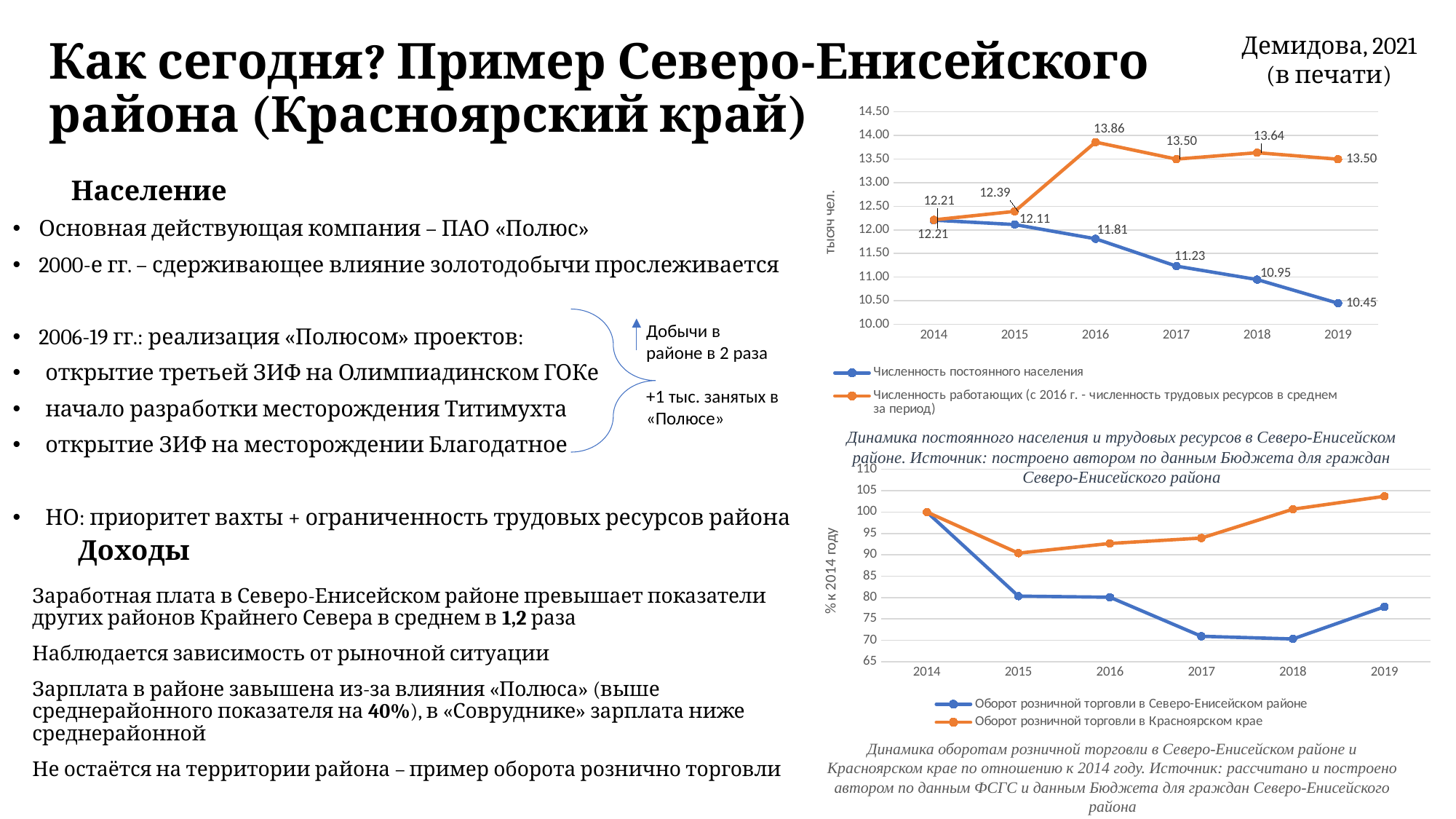
In the bottom chart, is the value for Оборот розничной торговли в Северо-Енисейском районе in 2018 greater or less than 75? less In the top chart, what is the difference between Численность работающих and Численность постоянного населения in 2019? 3.05 In the top chart, in which year was the permanent population (blue series) highest? 2014 How many years are plotted on the x axis of the top chart? 6 In the top chart, which series has the larger value in 2017: Численность постоянного населения or Численность работающих? Численность работающих In the top chart, does the permanent population rise or fall from 2014 to 2019? fall In the top chart, in which year was the Численность работающих series lowest? 2014 In the top chart, what was the permanent population (Численность постоянного населения) in 2019? 10.45 In the top chart, what was the value for Численность работающих in 2016? 13.86 In the bottom chart, is the value for Оборот розничной торговли в Красноярском крае in 2019 greater or less than 100? greater How many series does the legend of the bottom chart list? 2 What type of chart is the bottom chart showing retail turnover? line chart